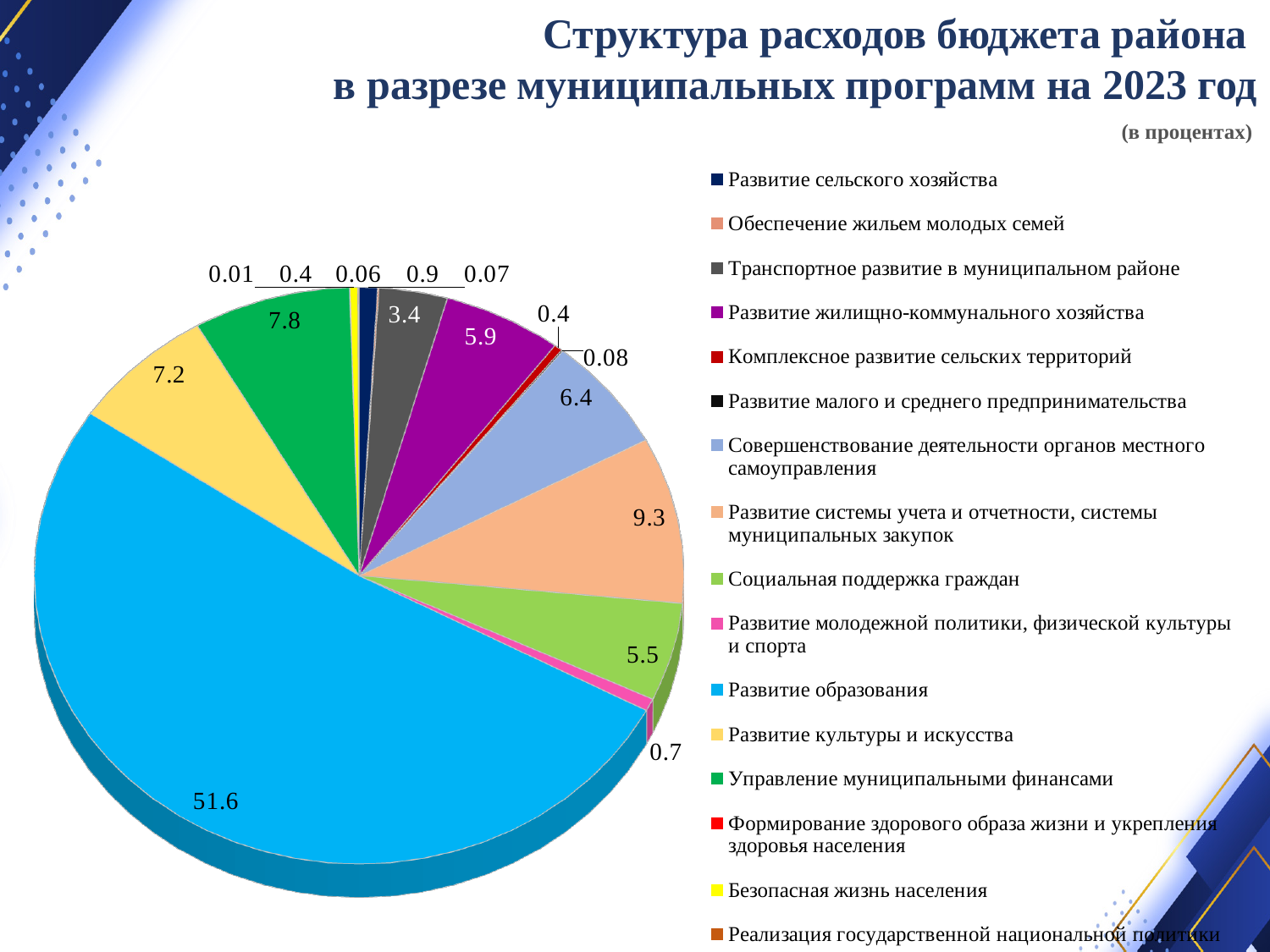
What is the value shown for Развитие культуры и искусства? 7.2 What is the difference between the values for Развитие системы учета и отчетности, системы муниципальных закупок and Социальная поддержка граждан? 3.8 What kind of chart is shown on the slide? pie chart How many categories does the legend list? 16 What is the value shown for Социальная поддержка граждан? 5.5 What is the value shown for Развитие системы учета и отчетности, системы муниципальных закупок? 9.3 What is the value shown for Транспортное развитие в муниципальном районе? 3.4 Which category has the largest share of the pie? Развитие образования Which is larger: Управление муниципальными финансами or Развитие культуры и искусства? Управление муниципальными финансами What is the value shown for Развитие образования? 51.6 What is the smallest value labelled on the pie chart? 0.01 What is the value shown for Управление муниципальными финансами? 7.8